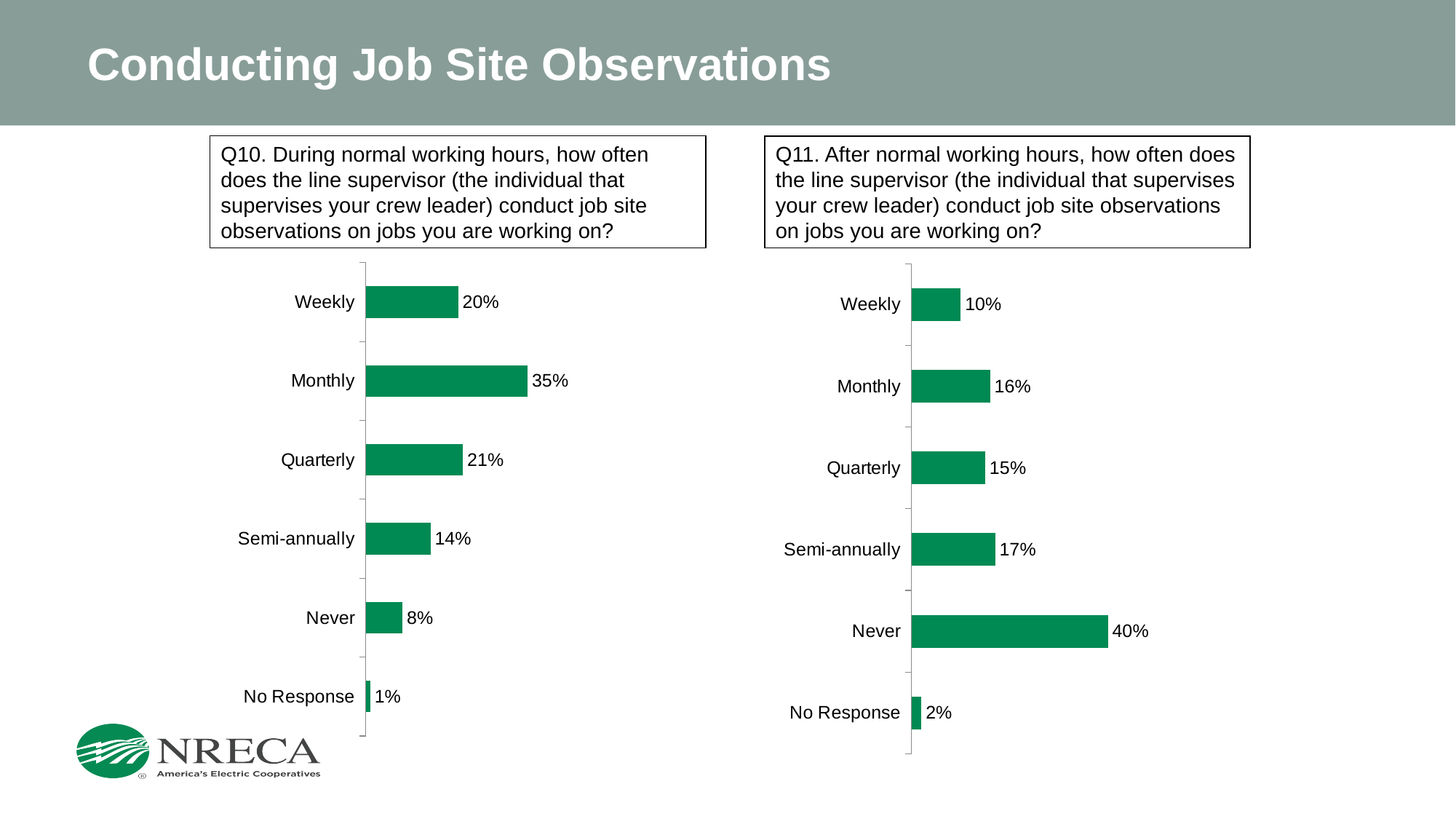
How many categories are shown in the Q10 chart (left)? 6 In the Q10 chart (left), what is the difference between the Quarterly and Semi-annually values? 7% In the Q11 chart (right), which is larger, the value for Monthly or the value for Quarterly? Monthly What kind of chart is the Q11 chart (right)? Bar chart In the Q10 chart (left, during normal working hours), what percentage of respondents answered Monthly? 35% In the Q11 chart (right), what is the difference between the Never and Weekly values? 30% In the Q11 chart (right), what percentage of respondents answered Semi-annually? 17% In the Q11 chart (right), which category has the lowest value? No Response In the Q11 chart (right, after normal working hours), what percentage of respondents answered Never? 40% In the Q10 chart (left), what percentage of respondents answered Never? 8% In the Q10 chart (left), which category has the highest value? Monthly What colour are the bars in both charts on the slide? Green